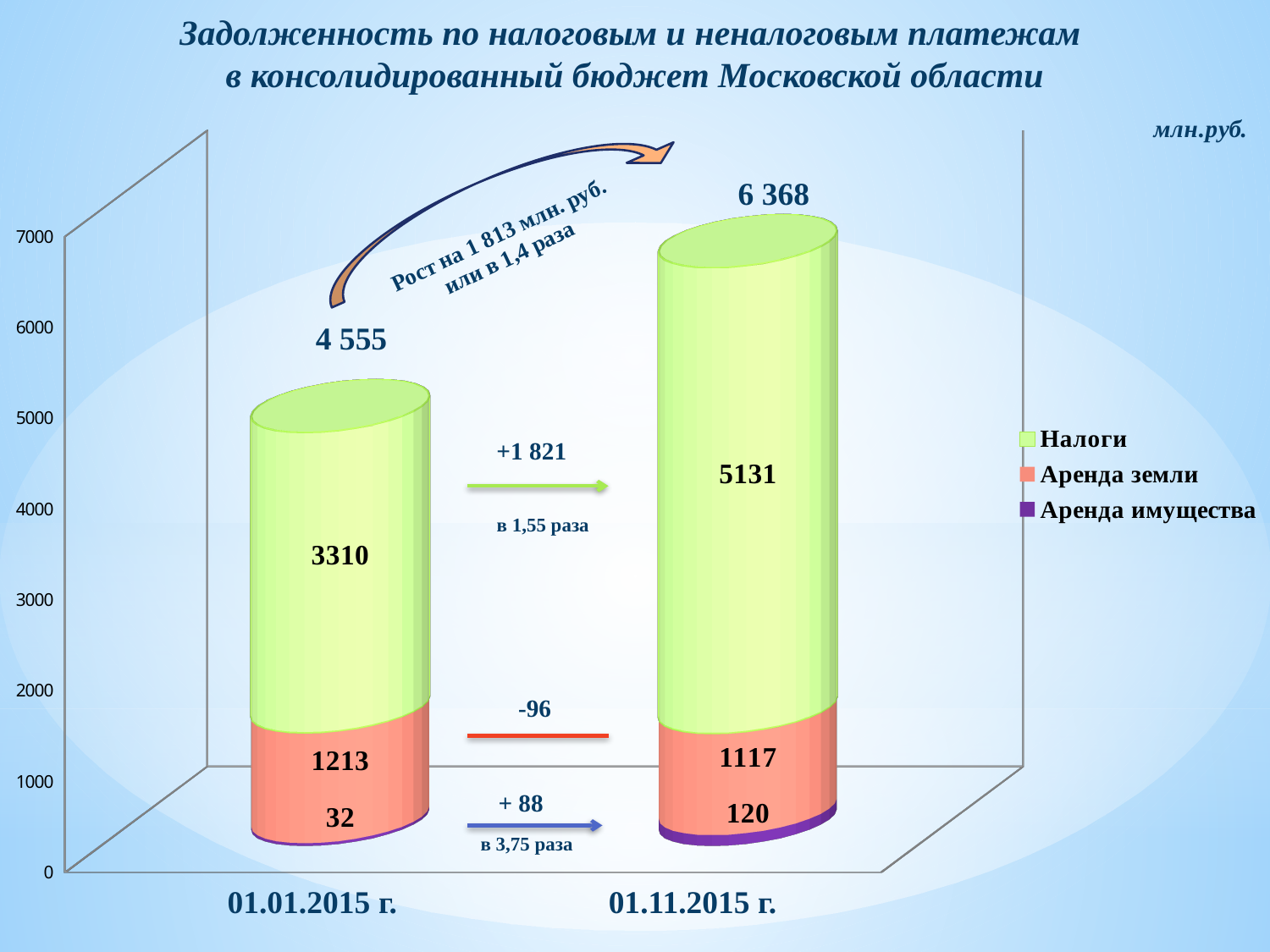
What is the value of Налоги for 01.11.2015 г.? 5131 Which series has the lowest value for 01.01.2015 г.? Аренда имущества How many series does the legend list? 3 What is the total of the stacked bar for 01.01.2015 г.? 4 555 Which series has the highest value for 01.11.2015 г.? Налоги Is the value of Аренда земли larger for 01.01.2015 г. or for 01.11.2015 г.? 01.01.2015 г. What is the value of Аренда земли for 01.01.2015 г.? 1213 How many categories are shown on the x axis? 2 What is the total of the stacked bar for 01.11.2015 г.? 6 368 What is the value of Аренда имущества for 01.11.2015 г.? 120 What kind of chart is shown on the slide? Stacked bar chart What is the difference between the Налоги values for 01.11.2015 г. and 01.01.2015 г.? 1821